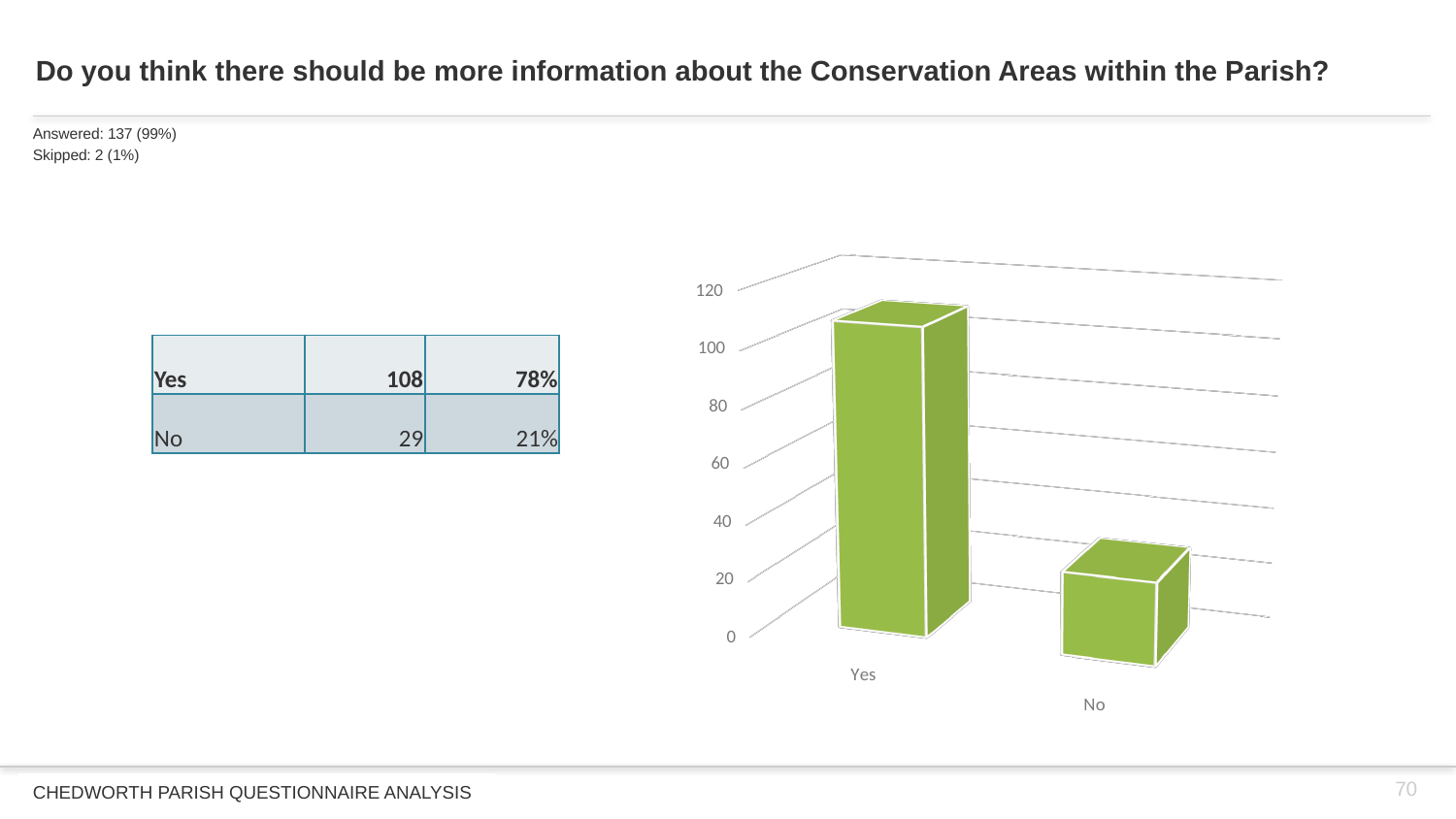
How many categories does the bar chart show? 2 According to the table on the slide, how many respondents answered No? 29 Which category has the highest bar in the chart? Yes What is the highest value shown on the chart's vertical axis? 120 Using the counts in the table, what is the difference between the Yes and No counts? 79 Which is larger, the value for Yes or the value for No? Yes Is the value for Yes greater or less than 100? greater Which category has the lowest bar in the chart? No Is the value for No greater or less than 40? less According to the table on the slide, how many respondents answered Yes? 108 According to the table on the slide, what percentage of respondents answered Yes? 78% What kind of chart is shown on the slide? bar chart